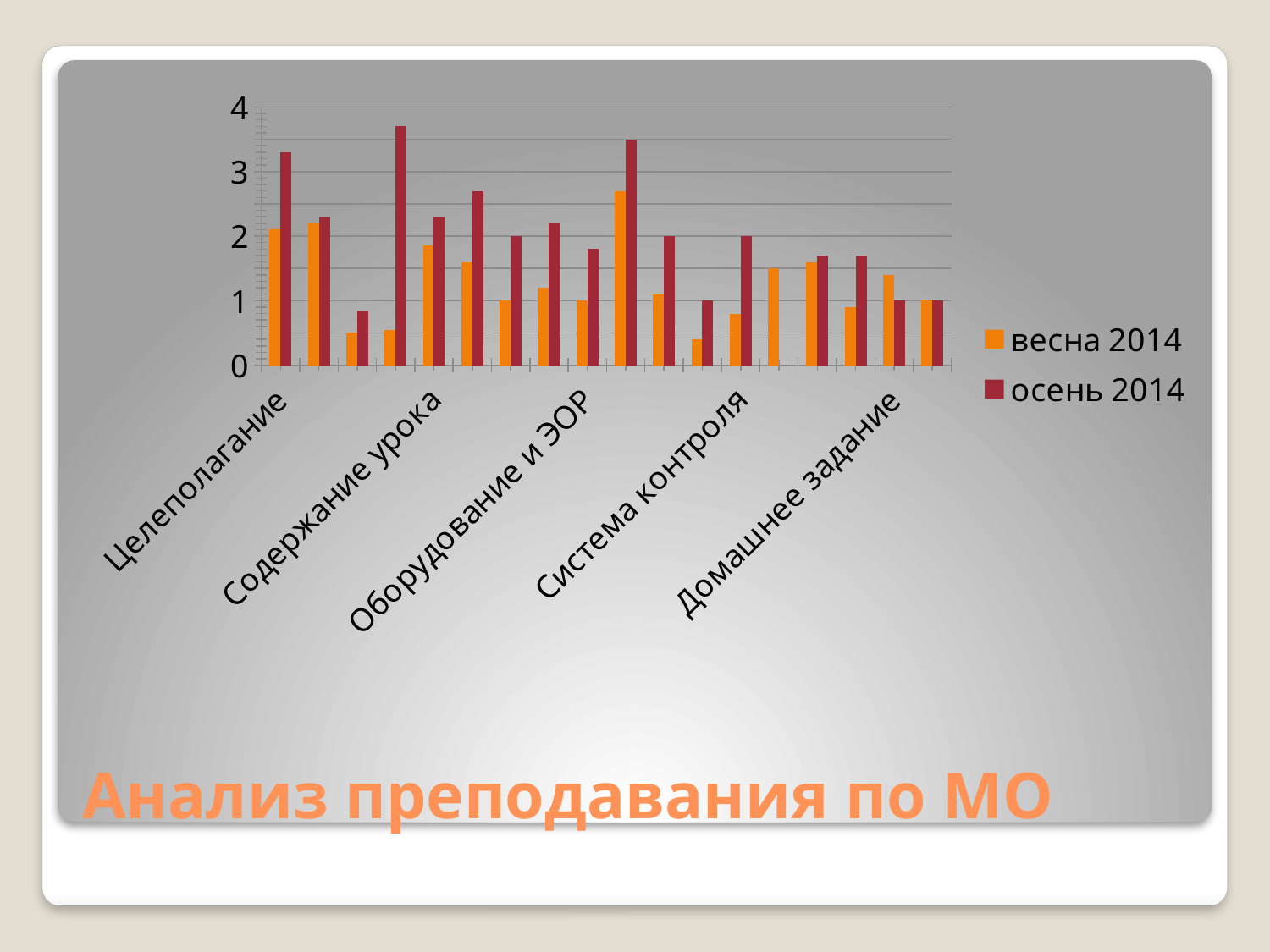
What is the title shown on the slide? Анализ преподавания по МО For Целеполагание, which series has the larger value, весна 2014 or осень 2014? осень 2014 What are the two series named in the legend? весна 2014 and осень 2014 What kind of chart is shown on the slide? bar chart What is the highest value shown on the vertical axis? 4 How many series does the legend list? 2 Which series contains the tallest bar on the chart? осень 2014 Is the весна 2014 value for Целеполагание greater or less than 1? greater Is the осень 2014 value for Целеполагание greater or less than 3? greater Is the tallest bar on the chart greater or less than 3? greater